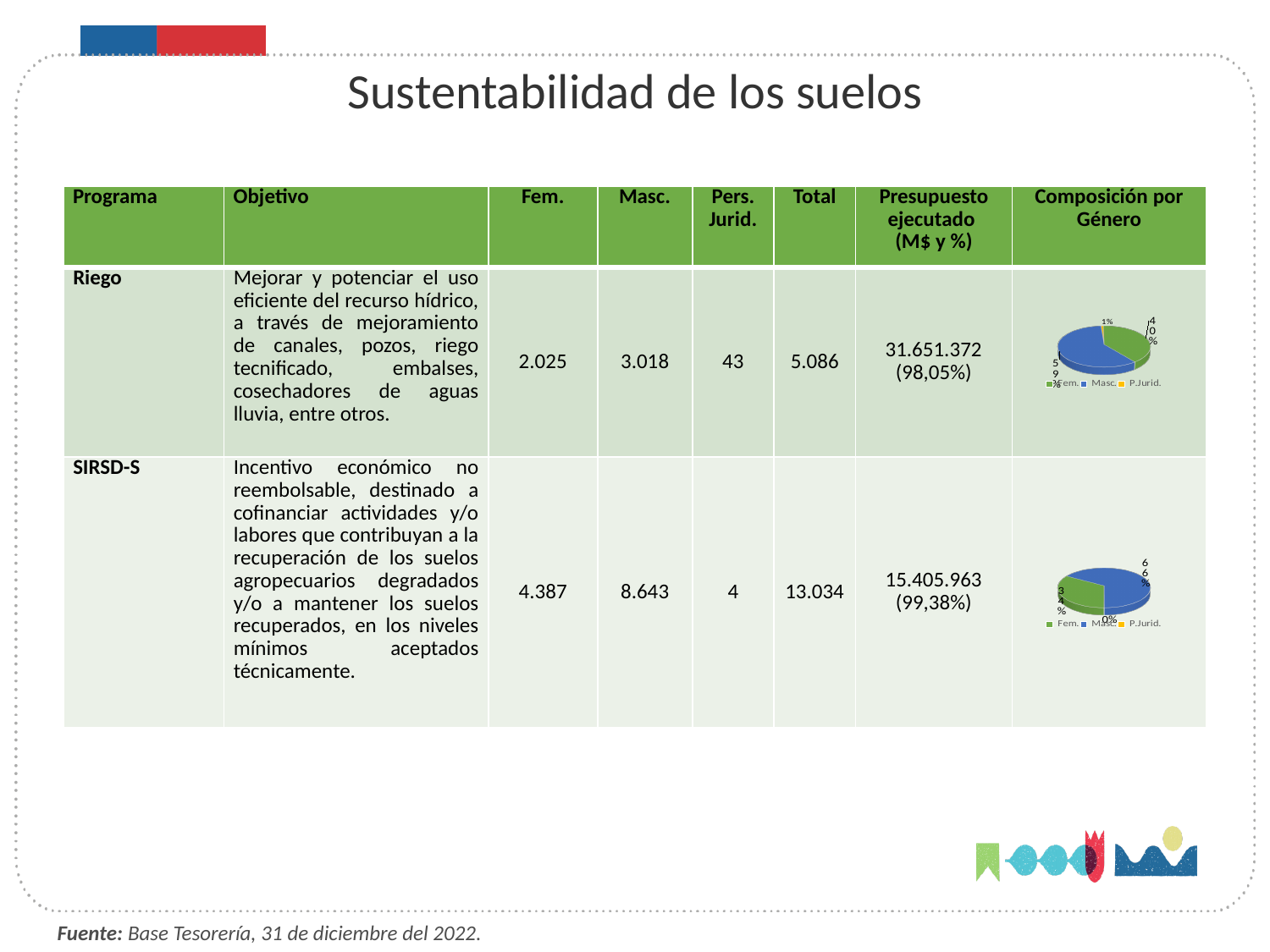
In the Riego pie chart, what share is labelled for the Fem. slice? 40% How many pie charts are shown on the slide? 2 In the SIRSD-S pie chart, what share is labelled for the Fem. slice? 34% In the SIRSD-S pie chart, what share is labelled for the Masc. slice? 66% What kind of chart is shown in the Composición por Género column for the Riego row? pie chart In the Riego pie chart, which category has the smallest slice? P.Jurid. In the SIRSD-S pie chart, which category has the largest slice? Masc. What are the legend entries of the SIRSD-S pie chart? Fem., Masc., P.Jurid. In the Riego pie chart, which category has the largest slice? Masc. In the SIRSD-S pie chart, is the Fem. slice or the Masc. slice larger? Masc. How many entries does the legend of the Riego pie chart list? 3